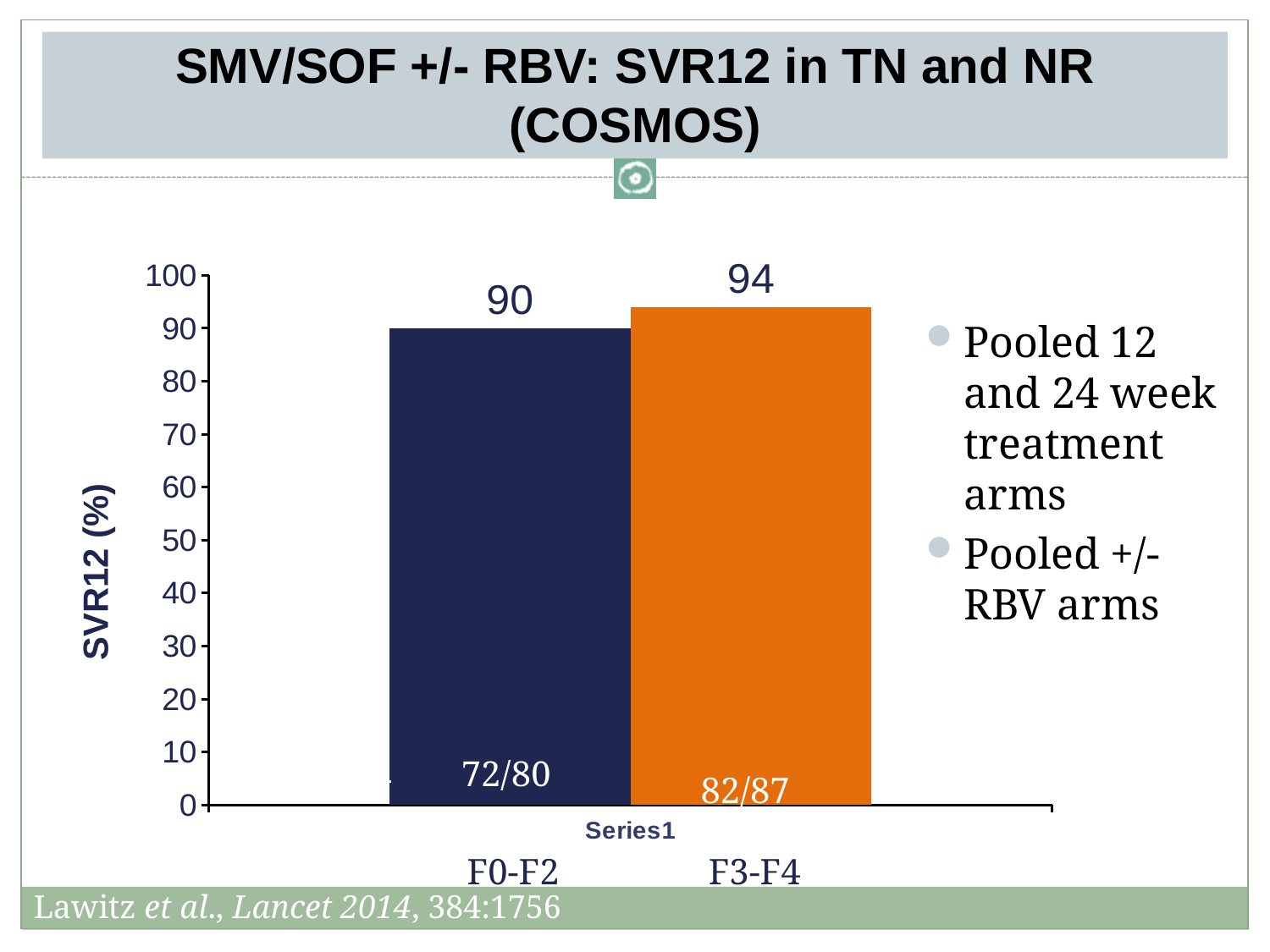
What is the SVR12 (%) value for F3-F4? 94 Is the SVR12 value for F0-F2 greater or less than 80? greater What is the difference in SVR12 (%) between F3-F4 and F0-F2? 4 What colour is the F3-F4 bar? orange What fraction is printed on the F3-F4 bar? 82/87 How many bars are shown in the chart? 2 Which group has the higher SVR12 (%), F0-F2 or F3-F4? F3-F4 What is the SVR12 (%) value for F0-F2? 90 What fraction is printed on the F0-F2 bar? 72/80 What is the label of the y axis? SVR12 (%) Which group has the lowest SVR12 (%)? F0-F2 What kind of chart is shown on the slide? bar chart